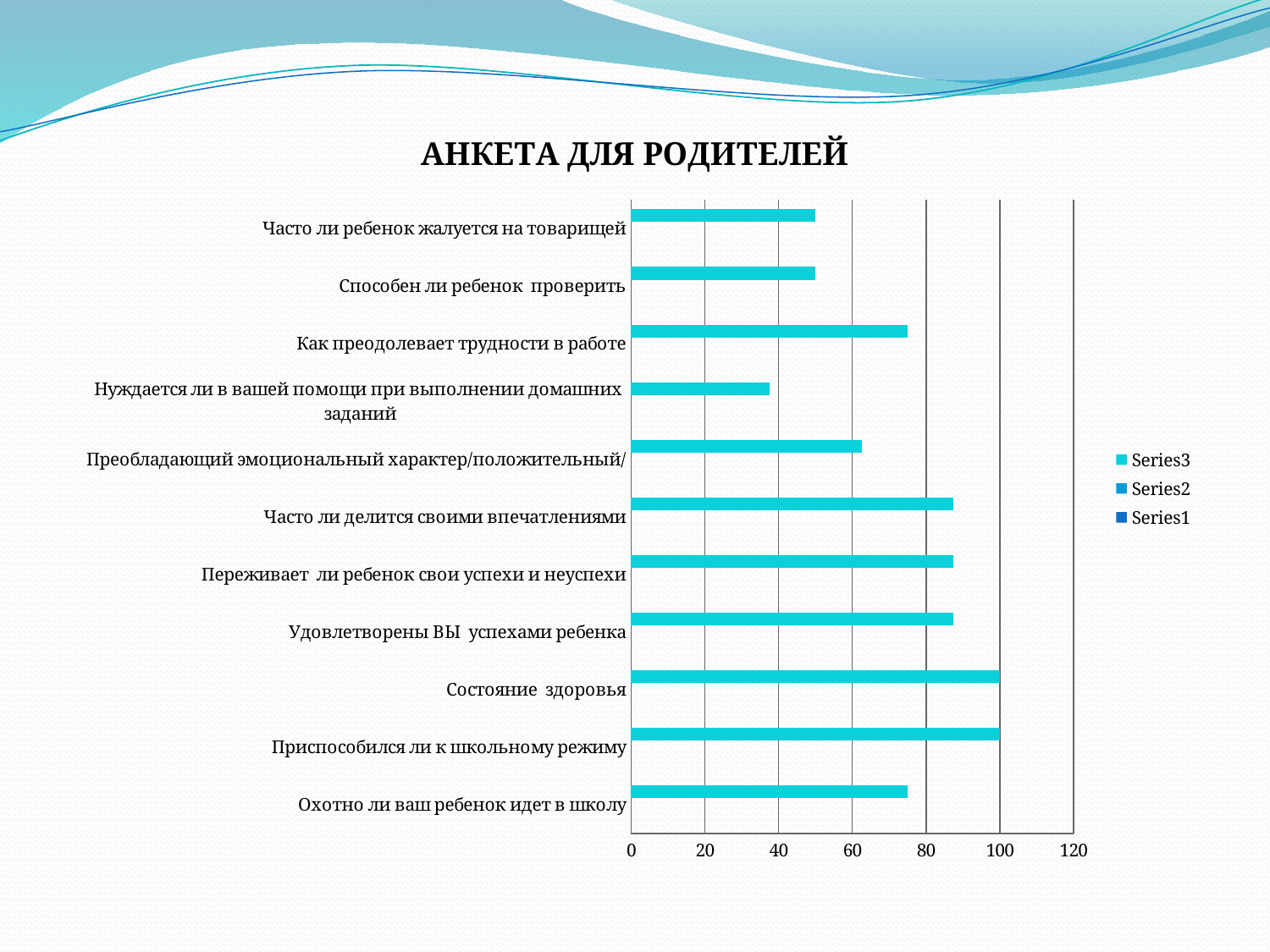
What is the value for "Приспособился ли к школьному режиму"? 100 Is the value for "Часто ли делится своими впечатлениями" greater or less than 80? greater Which category has the lowest value? Нуждается ли в вашей помощи при выполнении домашних заданий What is the value for "Состояние здоровья"? 100 How many series does the legend list? 3 Which is larger: the value for "Состояние здоровья" or for "Охотно ли ваш ребенок идет в школу"? Состояние здоровья Is the value for "Нуждается ли в вашей помощи при выполнении домашних заданий" greater or less than 60? less Which is larger: the value for "Как преодолевает трудности в работе" or for "Способен ли ребенок проверить"? Как преодолевает трудности в работе Is the value for "Охотно ли ваш ребенок идет в школу" greater or less than 80? less What is the title of the chart? АНКЕТА ДЛЯ РОДИТЕЛЕЙ How many categories are plotted on the chart? 11 What type of chart is shown on the slide? Bar chart